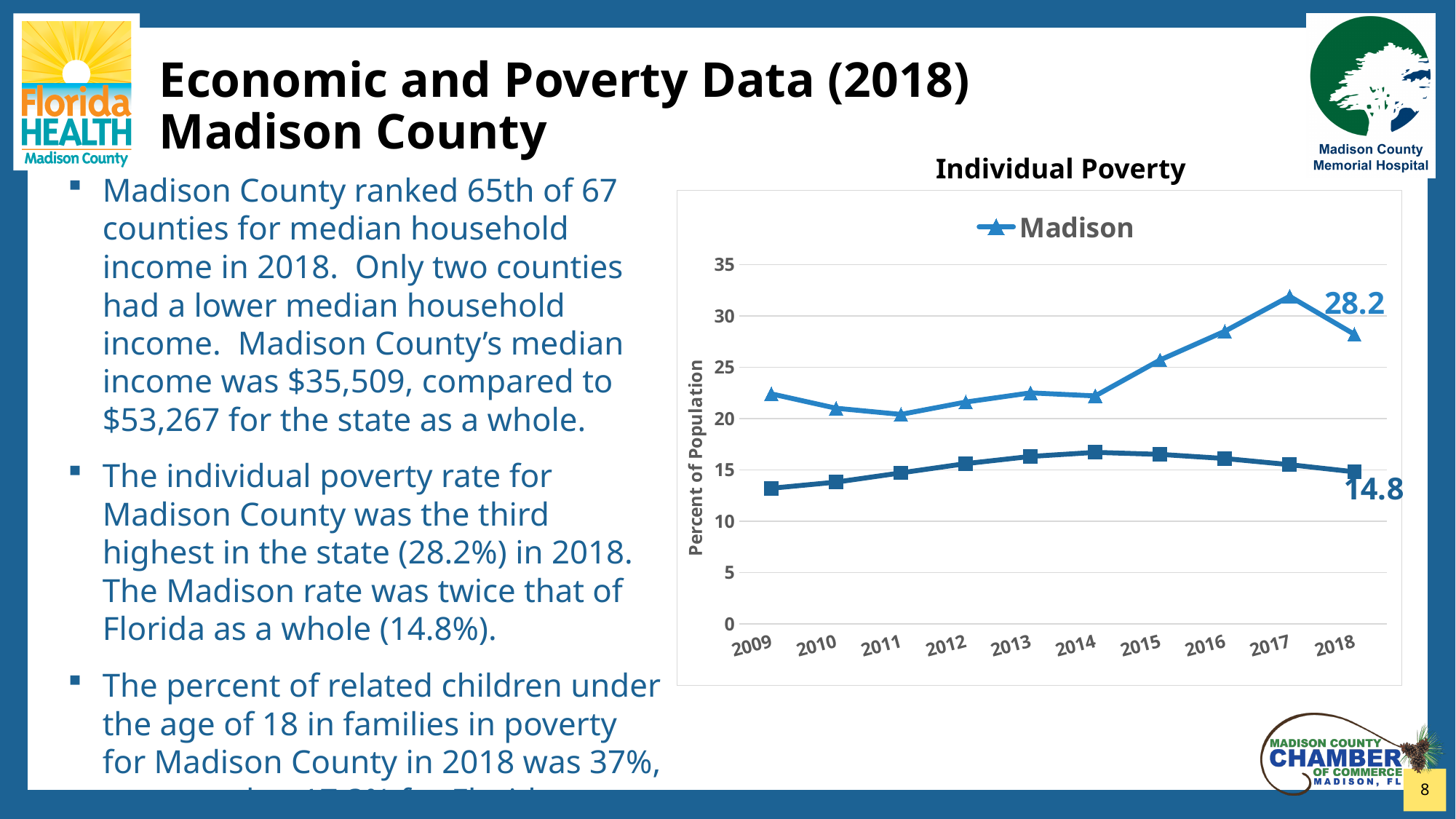
In which year does the Madison line reach its highest value in the Individual Poverty chart? 2017 In the Individual Poverty chart, what is the difference between the Madison 2018 value and the 2018 value on the lower dark blue line? 13.4 Is the 2009 value on the lower dark blue line greater or less than 15? less What is the label on the vertical axis of the Individual Poverty chart? Percent of Population Is the Madison value for 2017 greater or less than 30? greater In 2018, which is larger in the Individual Poverty chart: the Madison value or the value on the lower dark blue line? Madison Does the Madison line rise or fall between 2014 and 2017 in the Individual Poverty chart? rise What is the Madison value for 2018 in the Individual Poverty chart? 28.2 What kind of chart is shown under the title "Individual Poverty"? line chart What is the 2018 value labelled on the lower, dark blue line with square markers in the Individual Poverty chart? 14.8 How many years are shown on the x axis of the Individual Poverty chart? 10 How many series does the legend of the Individual Poverty chart list? 1